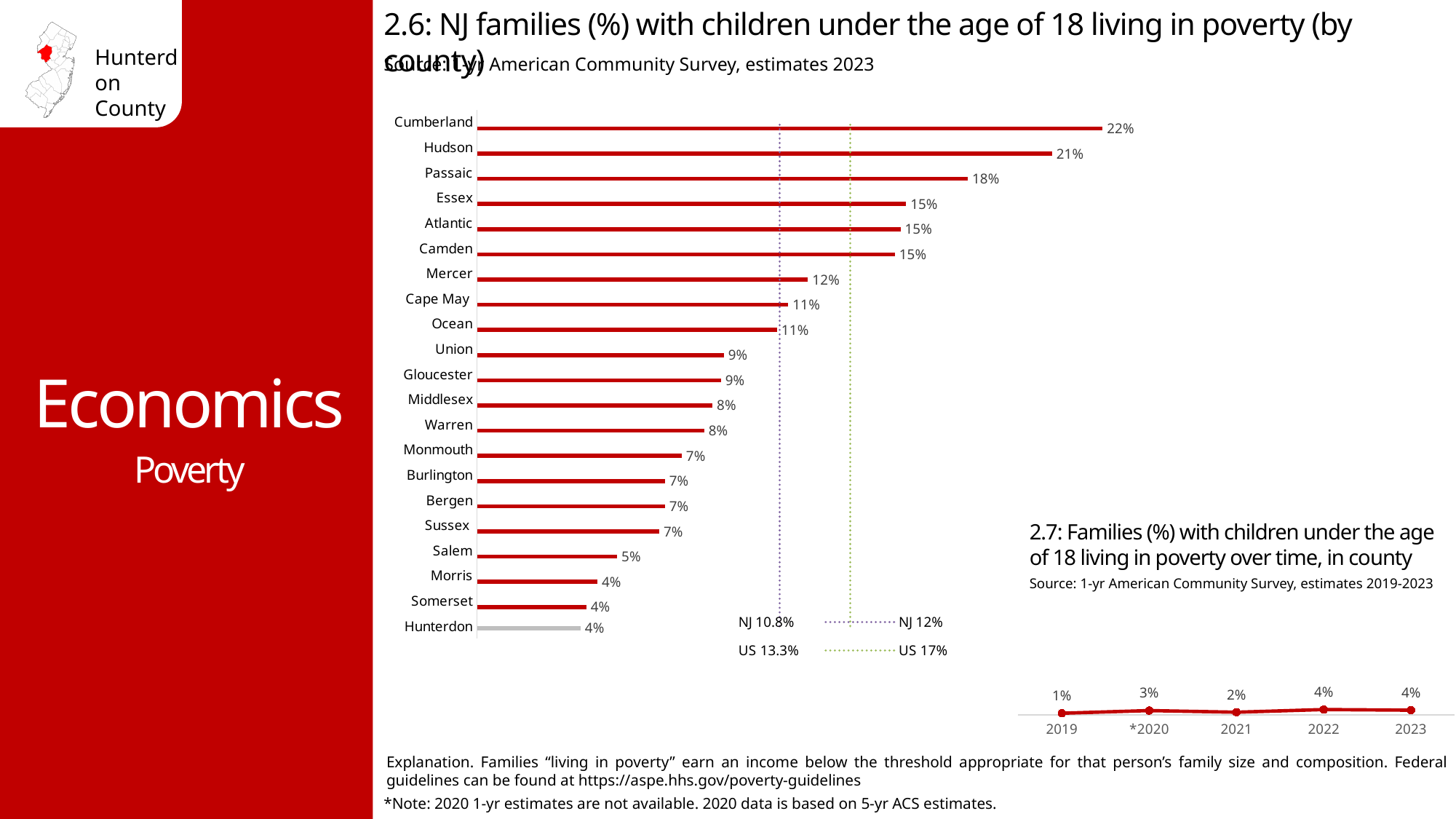
In chart 2.6, which is larger, the value for Mercer or the value for Union? Mercer In chart 2.7, what is the value for 2019? 1% In chart 2.7, what is the value for 2022? 4% In chart 2.6, what is the value for Hunterdon? 4% In chart 2.6, which county has the highest value? Cumberland In chart 2.6, how many counties are listed? 21 What kind of chart is chart 2.6? Bar chart In chart 2.6, what is the value for Cumberland? 22% In chart 2.7, how many years are plotted? 5 In chart 2.6, what is the value for Salem? 5% In chart 2.6, what is the difference between the values for Hudson and Passaic? 3%